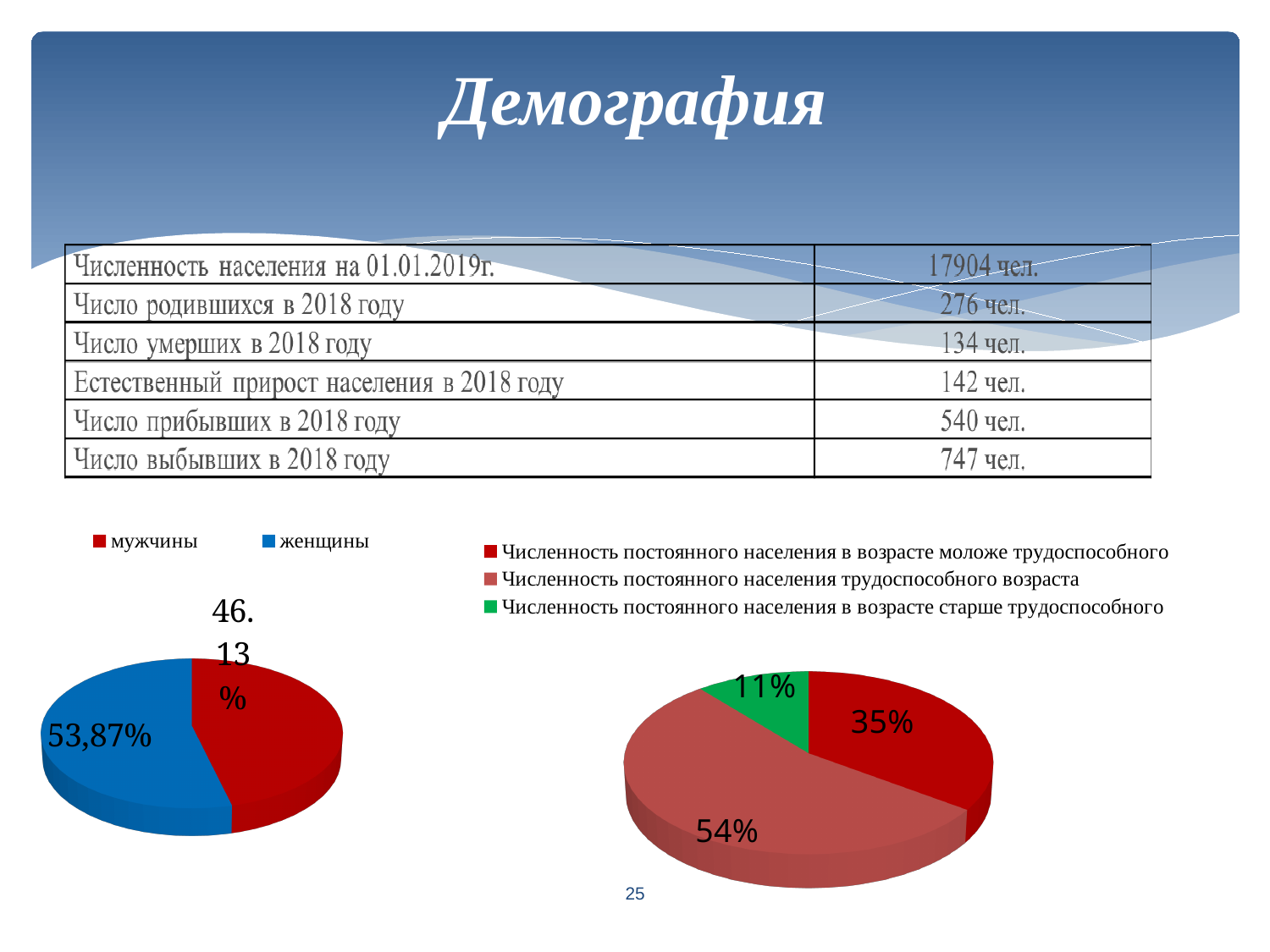
In the left pie chart, what share is shown for мужчины? 46.13% How many entries does the legend of the left pie chart list? 2 In the right pie chart, which category has the smallest share? Численность постоянного населения в возрасте старше трудоспособного In the right pie chart, which category has the largest share? Численность постоянного населения трудоспособного возраста In the left pie chart, what share is shown for женщины? 53,87% In the right pie chart, what share is shown for Численность постоянного населения в возрасте моложе трудоспособного? 35% What kind of chart is the left chart on the slide? pie chart In the right pie chart, what is the difference in percentage points between the share of working-age population (54%) and the share younger than working age (35%)? 19 In the right pie chart, what share is shown for Численность постоянного населения трудоспособного возраста? 54% In the right pie chart, what share is shown for Численность постоянного населения в возрасте старше трудоспособного? 11% In the left pie chart, which category has the larger share, мужчины or женщины? женщины In the left pie chart, what colour is the slice for мужчины? red